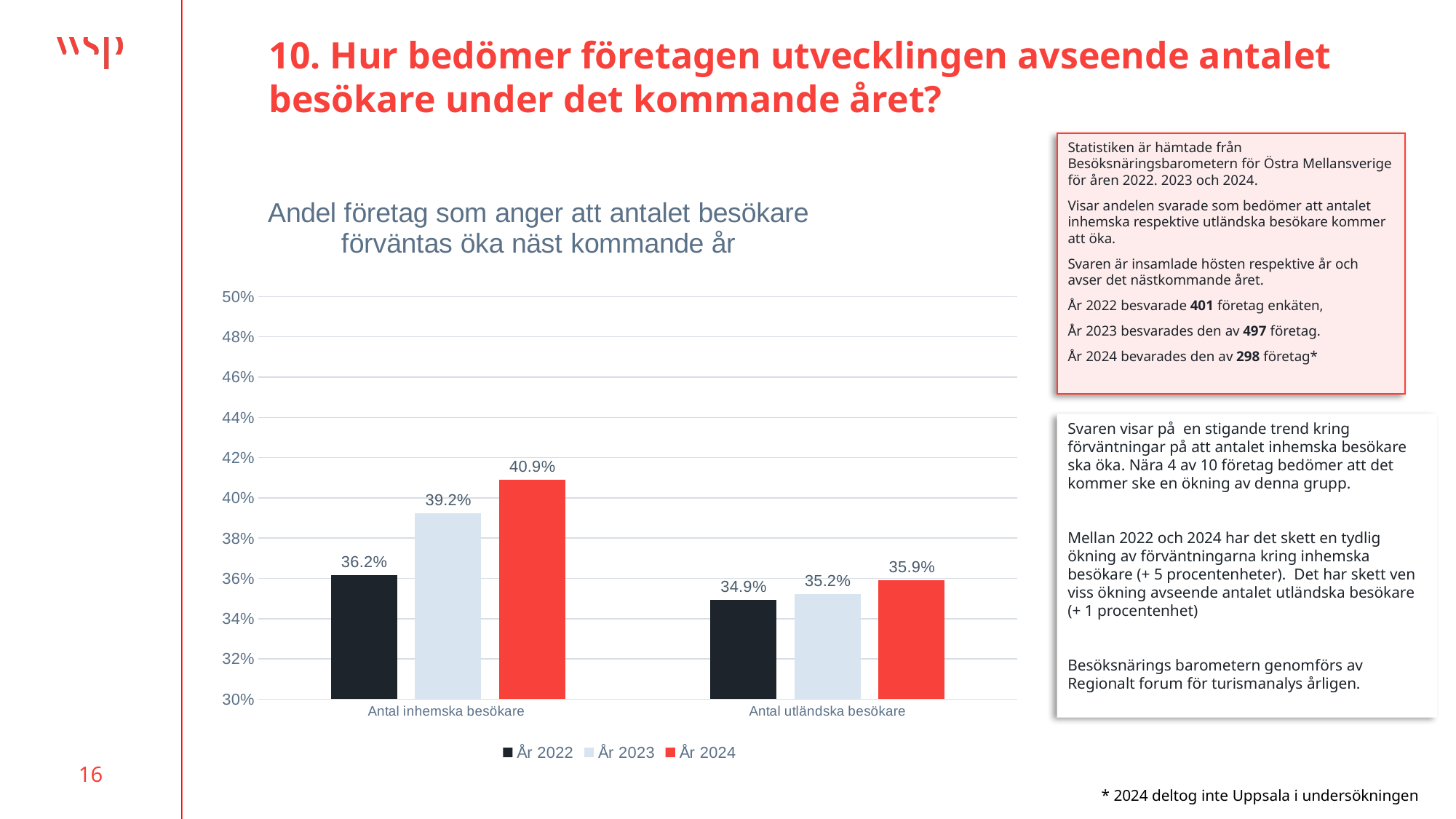
How many categories are shown on the x axis? 2 What kind of chart is shown on the slide? bar chart What is the value for År 2024 in the Antal inhemska besökare category? 40.9% Which is larger: the År 2024 value for Antal inhemska besökare or the År 2024 value for Antal utländska besökare? Antal inhemska besökare Which year has the lowest value in the Antal utländska besökare category? År 2022 Is the År 2023 value for Antal utländska besökare greater or less than 36%? less Which year has the highest value in the Antal inhemska besökare category? År 2024 What is the value for År 2023 in the Antal inhemska besökare category? 39.2% Do the values for Antal utländska besökare rise or fall from År 2022 to År 2024? rise How many series does the legend list? 3 What is the value for År 2022 in the Antal utländska besökare category? 34.9% What is the difference between the År 2024 and År 2022 values for Antal inhemska besökare? 4.7 percentage points